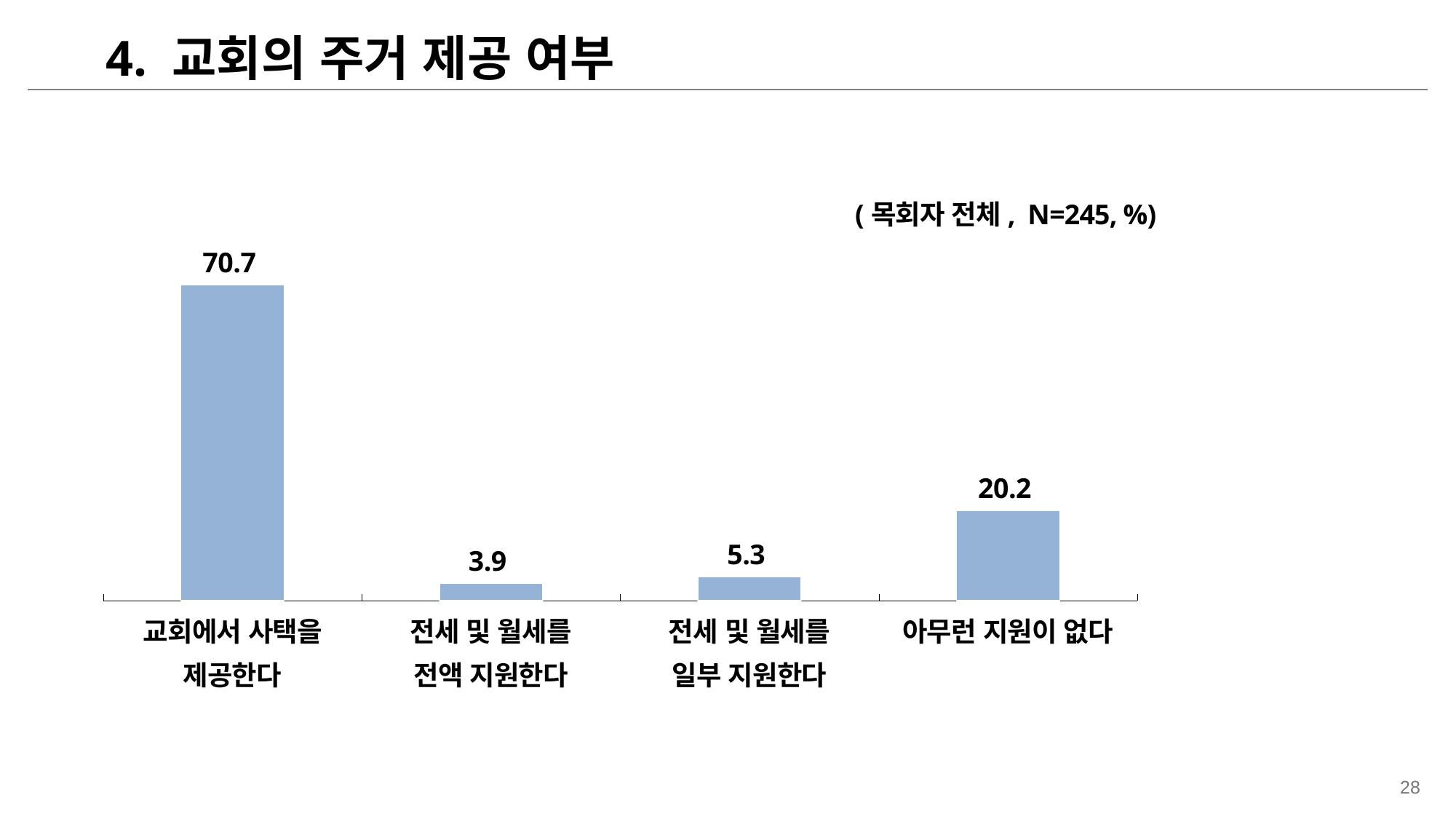
What sample size (N) is stated on the slide for the chart? N=245 What is the value for 전세 및 월세를 일부 지원한다? 5.3 Which is larger, the value for 아무런 지원이 없다 or the value for 전세 및 월세를 일부 지원한다? 아무런 지원이 없다 What is the value for 전세 및 월세를 전액 지원한다? 3.9 How many categories are shown in the chart? 4 Which category has the lowest value? 전세 및 월세를 전액 지원한다 What kind of chart is shown on the slide? Bar chart What is the difference between the values for 교회에서 사택을 제공한다 and 아무런 지원이 없다? 50.5 What is the value for 아무런 지원이 없다? 20.2 What is the value for 교회에서 사택을 제공한다? 70.7 Which category has the highest value? 교회에서 사택을 제공한다 What is the difference between the values for 전세 및 월세를 일부 지원한다 and 전세 및 월세를 전액 지원한다? 1.4